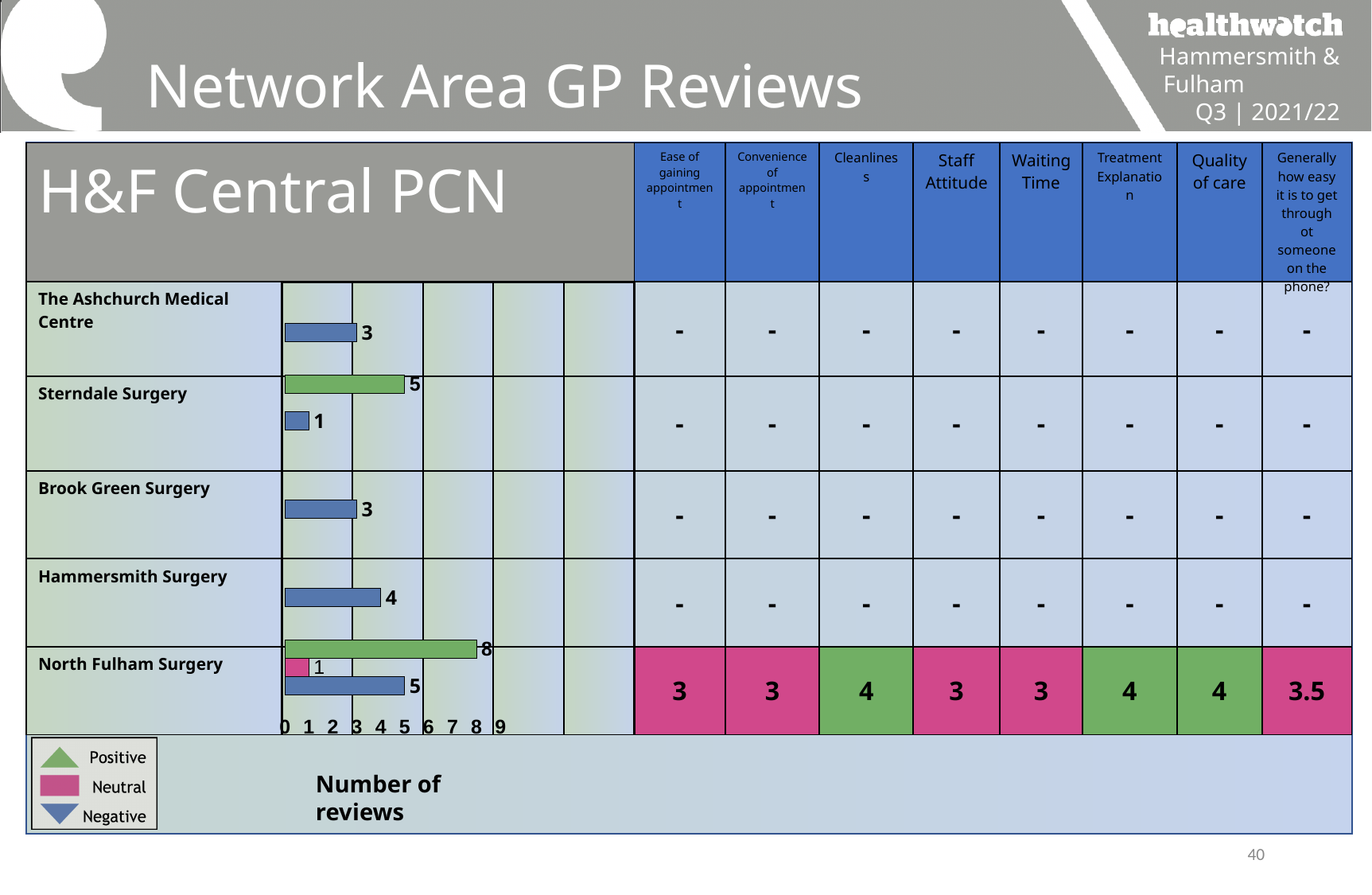
How many series does the legend of the reviews chart list? 3 How many negative reviews does The Ashchurch Medical Centre have? 3 Which has more negative reviews, Hammersmith Surgery or Brook Green Surgery? Hammersmith Surgery How many neutral reviews does North Fulham Surgery have? 1 Which surgery has the highest number of negative reviews? North Fulham Surgery How many negative reviews does Hammersmith Surgery have? 4 What type of chart is used to show the number of reviews for each surgery? Bar chart What is the total number of reviews for North Fulham Surgery across positive, neutral and negative? 14 How many positive reviews does North Fulham Surgery have? 8 Which colour represents positive reviews in the chart legend? Green How many positive reviews does Sterndale Surgery have? 5 What is the difference between the positive and negative review counts for North Fulham Surgery? 3